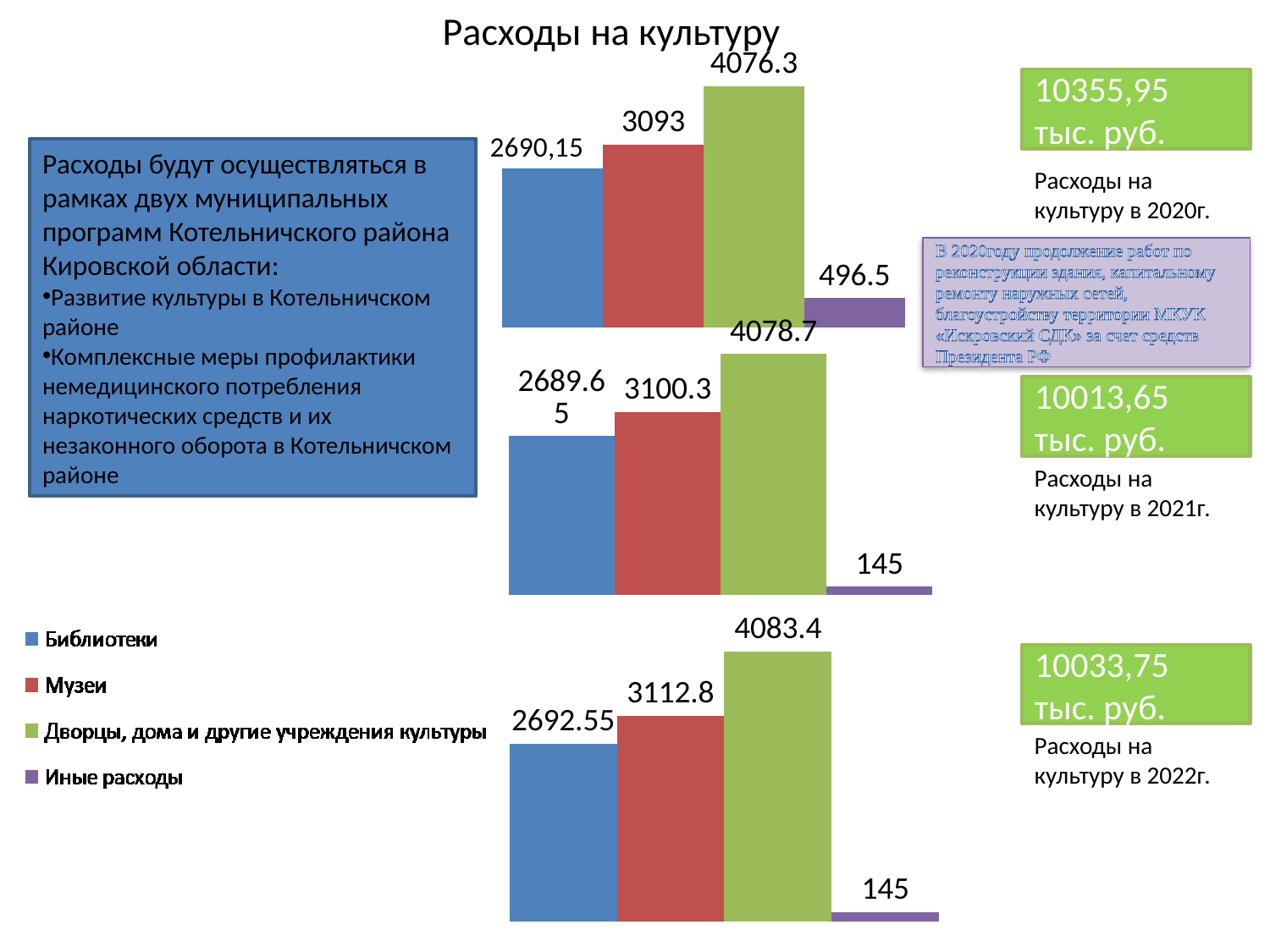
In the middle chart (2021), which category has the lowest value? Иные расходы In the bottom chart (2022), which is larger: the value for Музеи or the value for Библиотеки? Музеи In the top chart (2020), what is the difference between the values for Музеи and Библиотеки? 402,85 In the top chart (2020), what is the value for Иные расходы? 496.5 In the bottom chart (2022), what is the value for Музеи? 3112.8 What type of chart is used to show the culture expenditures on this slide? Bar chart How many categories are shown in each of the bar charts? 4 In the middle chart (2021), what is the value for Дворцы, дома и другие учреждения культуры? 4078.7 In the bottom chart (2022), which category has the highest value? Дворцы, дома и другие учреждения культуры Which colour represents Иные расходы in the legend? Purple How many series does the legend list? 4 In the top chart (2020), what is the value for Библиотеки? 2690,15